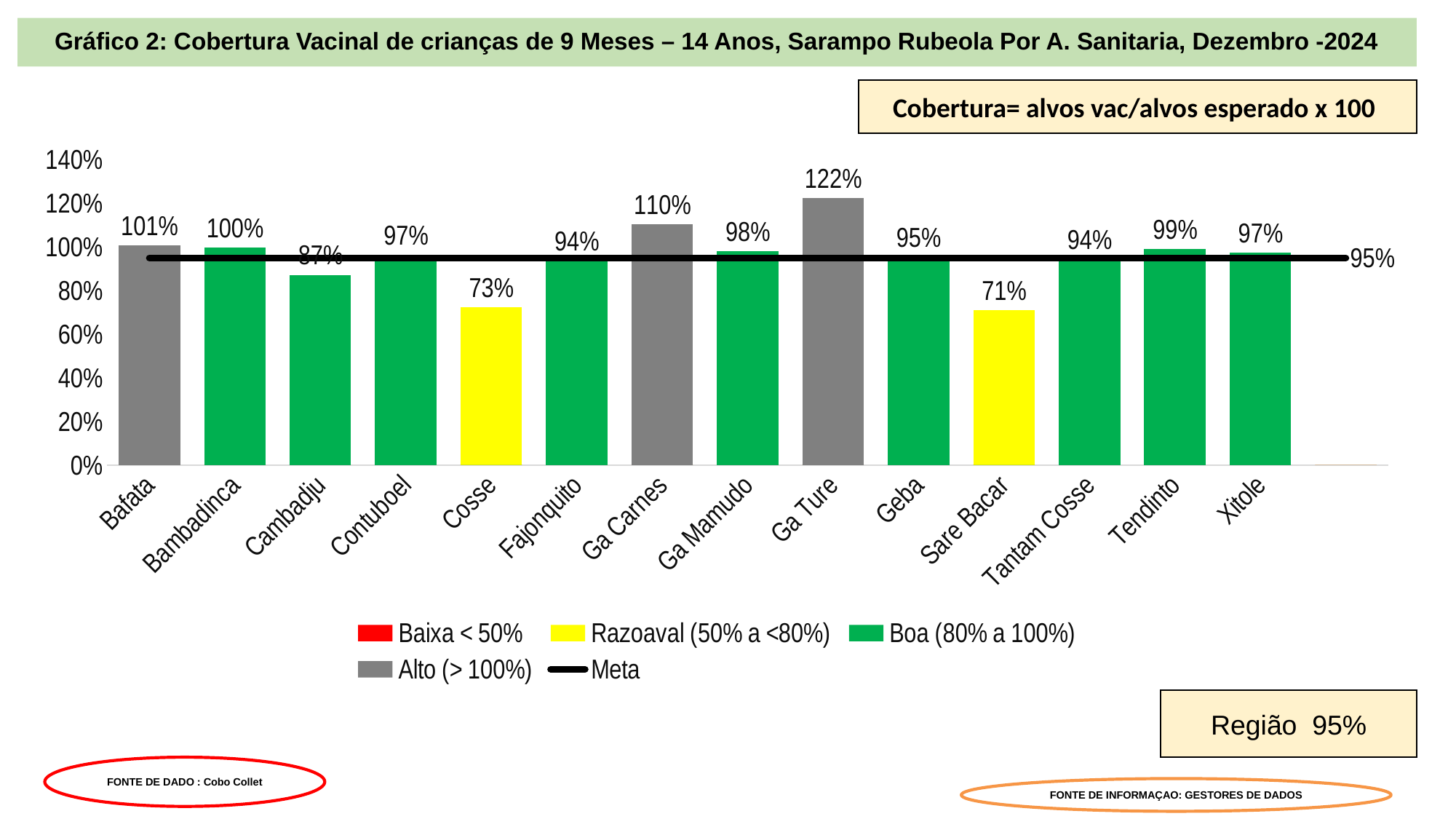
What kind of chart is this? bar chart How many health areas are shown on the x axis? 14 What is the difference between the coverage of Ga Carnes and Cosse? 37% Which health area has the highest coverage? Ga Ture Which has higher coverage, Tendinto or Fajonquito? Tendinto Which health area has the lowest coverage? Sare Bacar What is the coverage value shown for Bambadinca? 100% What is the coverage value shown for Sare Bacar? 71% What is the vaccination coverage value shown for Ga Ture? 122% Is the value for Cambadju greater or less than 100%? less What value is labelled on the Meta line? 95% How many entries does the legend list? 5